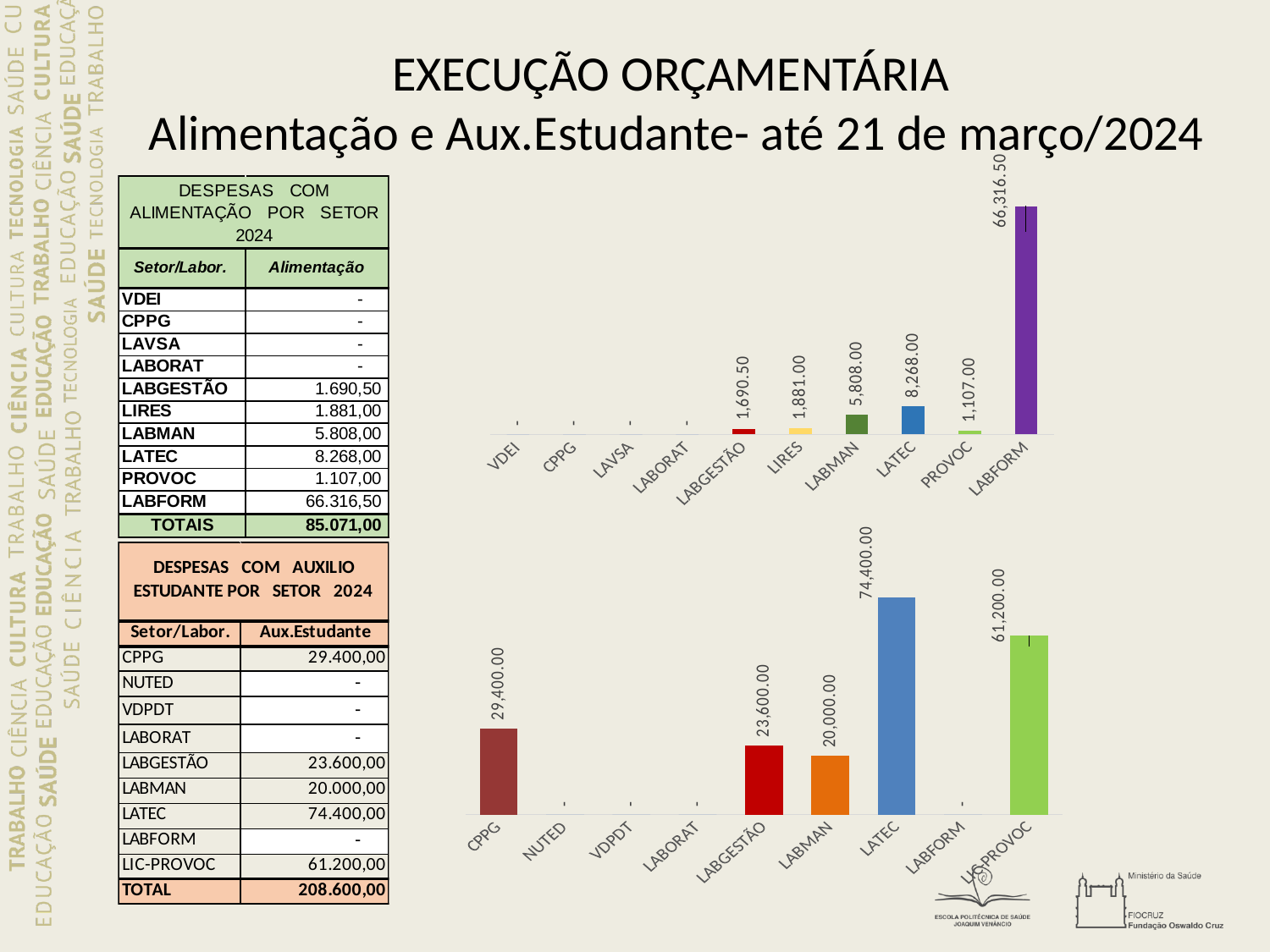
In the top chart, what is the difference between the values for LATEC and LABMAN? 2,460.00 In the top chart, what is the value for LATEC? 8,268.00 In the top chart, which is larger, the value for LIRES or the value for PROVOC? LIRES What type of chart is the bottom chart? Bar chart In the bottom chart, what is the value for LATEC? 74,400.00 In the bottom chart, which sector has the highest value? LATEC In the top chart, how many sectors are shown on the x axis? 10 In the top chart, which sector has the highest value? LABFORM In the bottom chart, how many sectors are shown on the x axis? 9 In the bottom chart, what is the value for LABMAN? 20,000.00 In the top chart, what is the value for LABFORM? 66,316.50 In the bottom chart, what is the difference between the values for LATEC and LIC-PROVOC? 13,200.00